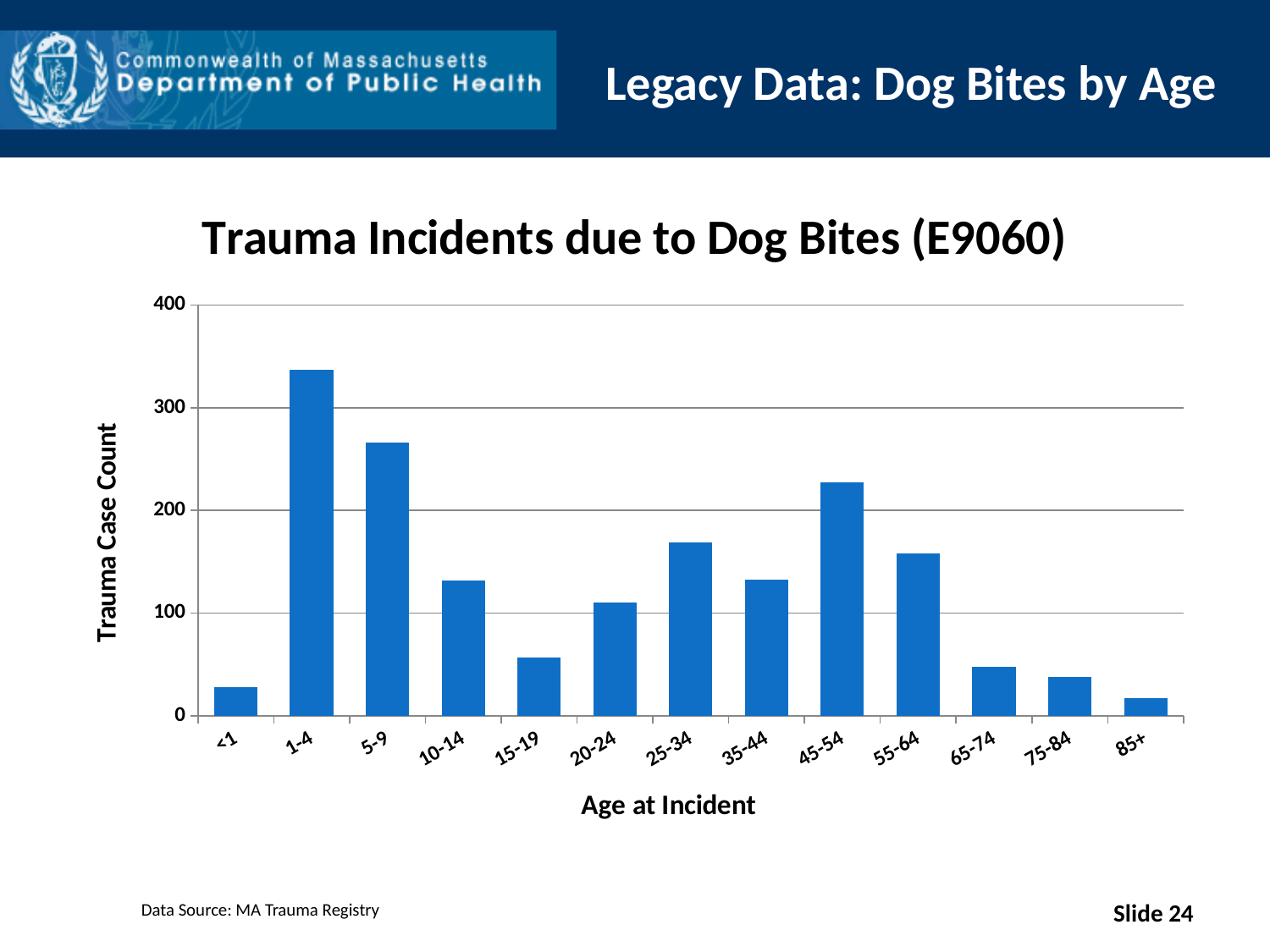
Which has a higher trauma case count, the 15-19 age group or the 20-24 age group? 20-24 Which has a higher trauma case count, the 5-9 age group or the 45-54 age group? 5-9 What kind of chart is shown on the slide? bar chart Which age group has the lowest trauma case count? 85+ Is the value for the 45-54 age group greater or less than 200? greater Is the value for the 15-19 age group greater or less than 100? less What is the title of the chart? Trauma Incidents due to Dog Bites (E9060) Is the value for the 1-4 age group greater or less than 300? greater What is the label of the y axis? Trauma Case Count How many age categories are shown on the x axis? 13 Which age group has the highest trauma case count? 1-4